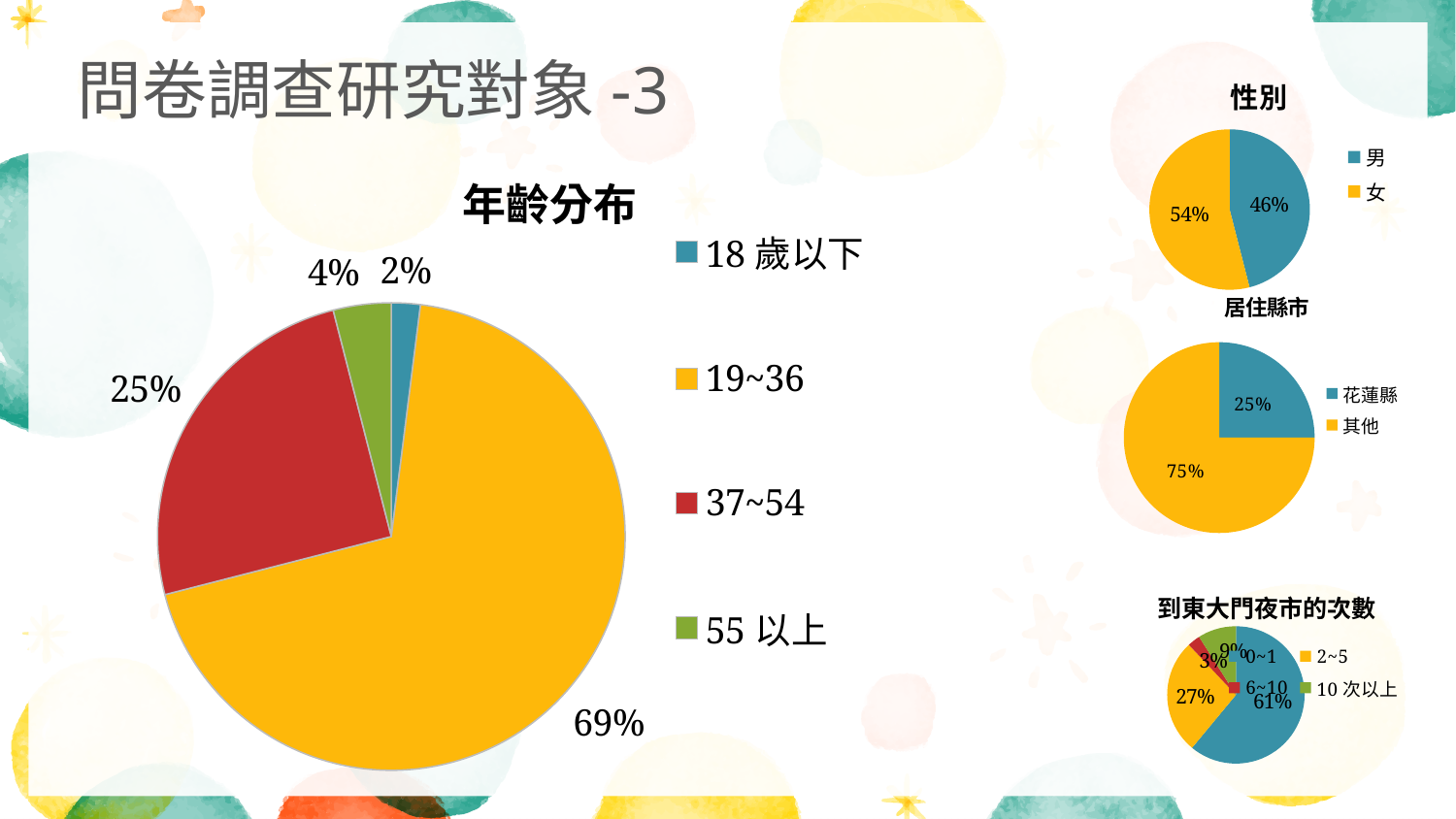
In the 年齡分布 chart, which age group has the largest share? 19~36 In the 性別 chart, which is larger, 男 or 女? 女 In the 年齡分布 chart, which age group has the smallest share? 18 歲以下 In the 年齡分布 chart, what percentage is shown for the 37~54 group? 25% In the 性別 chart, what percentage is shown for 女? 54% In the 到東大門夜市的次數 chart, which category has the largest share? 0~1 In the 居住縣市 chart, what percentage is shown for 花蓮縣? 25% What type of chart is the 年齡分布 chart? pie chart In the 到東大門夜市的次數 chart, what percentage is shown for 2~5? 27% How many categories does the 年齡分布 chart show? 4 In the 年齡分布 chart, what percentage is shown for the 19~36 group? 69% In the 年齡分布 chart, what is the difference in percentage points between the 37~54 group and the 55 以上 group? 21